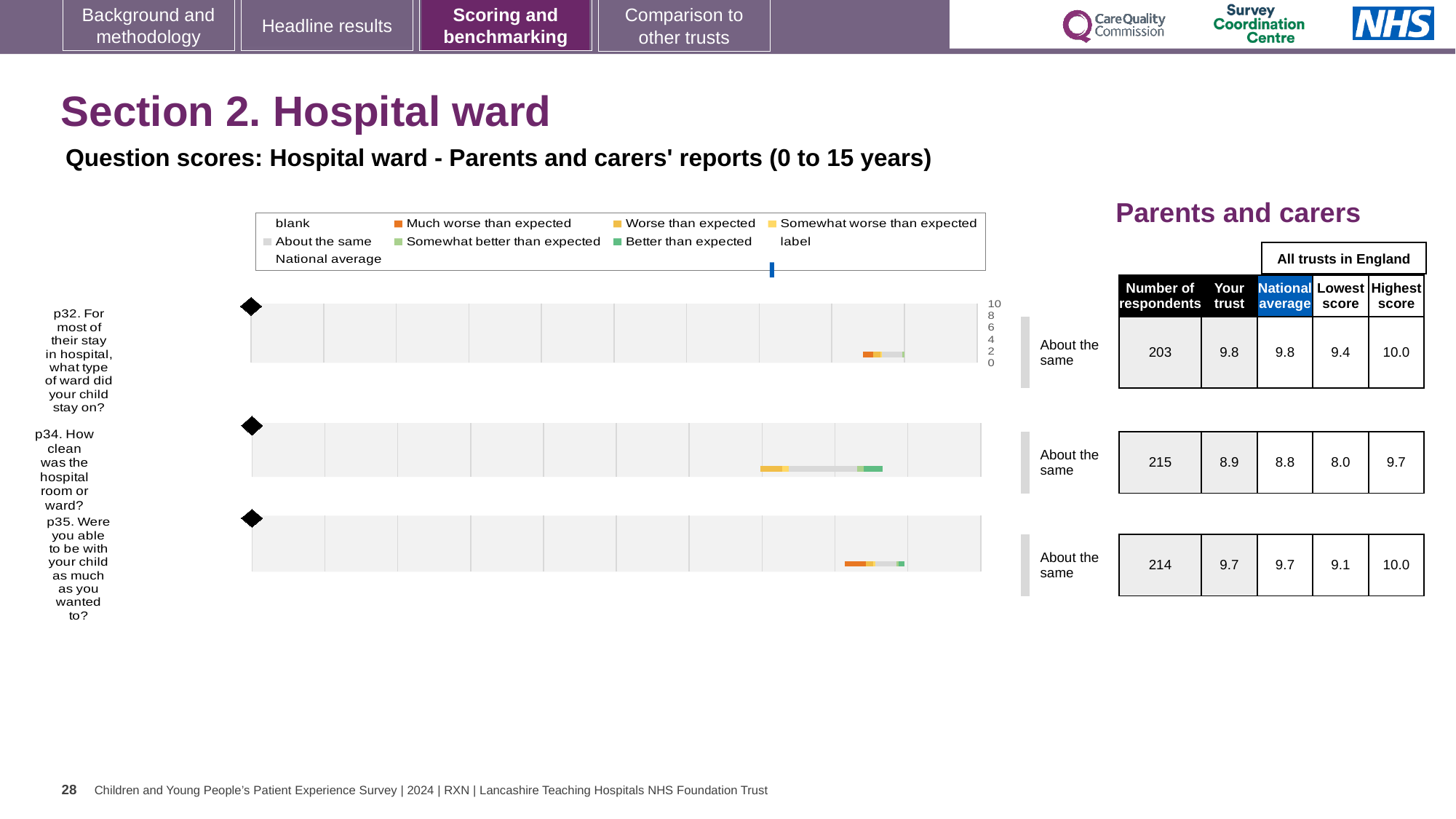
What benchmark category is shown for all three questions in the chart? About the same What colour does the legend use for 'Much worse than expected'? orange What is the difference between the highest score (9.7) and the lowest score (8.0) for p34? 1.7 For p34, which is larger: the 'Your trust' score or the national average? Your trust What is the national average score for p35 (Were you able to be with your child as much as you wanted to?)? 9.7 Which question has the highest 'Your trust' score? p32 Which question has the lowest 'Your trust' score? p34 How many questions (p32, p34, p35) are plotted in the chart? 3 What kind of chart is used to show the question scores for the hospital ward section? bar chart What is the difference between the 'Your trust' scores for p32 and p34? 0.9 What is the 'Your trust' score for p34 (How clean was the hospital room or ward?)? 8.9 How many respondents answered p32 (For most of their stay in hospital, what type of ward did your child stay on?)? 203